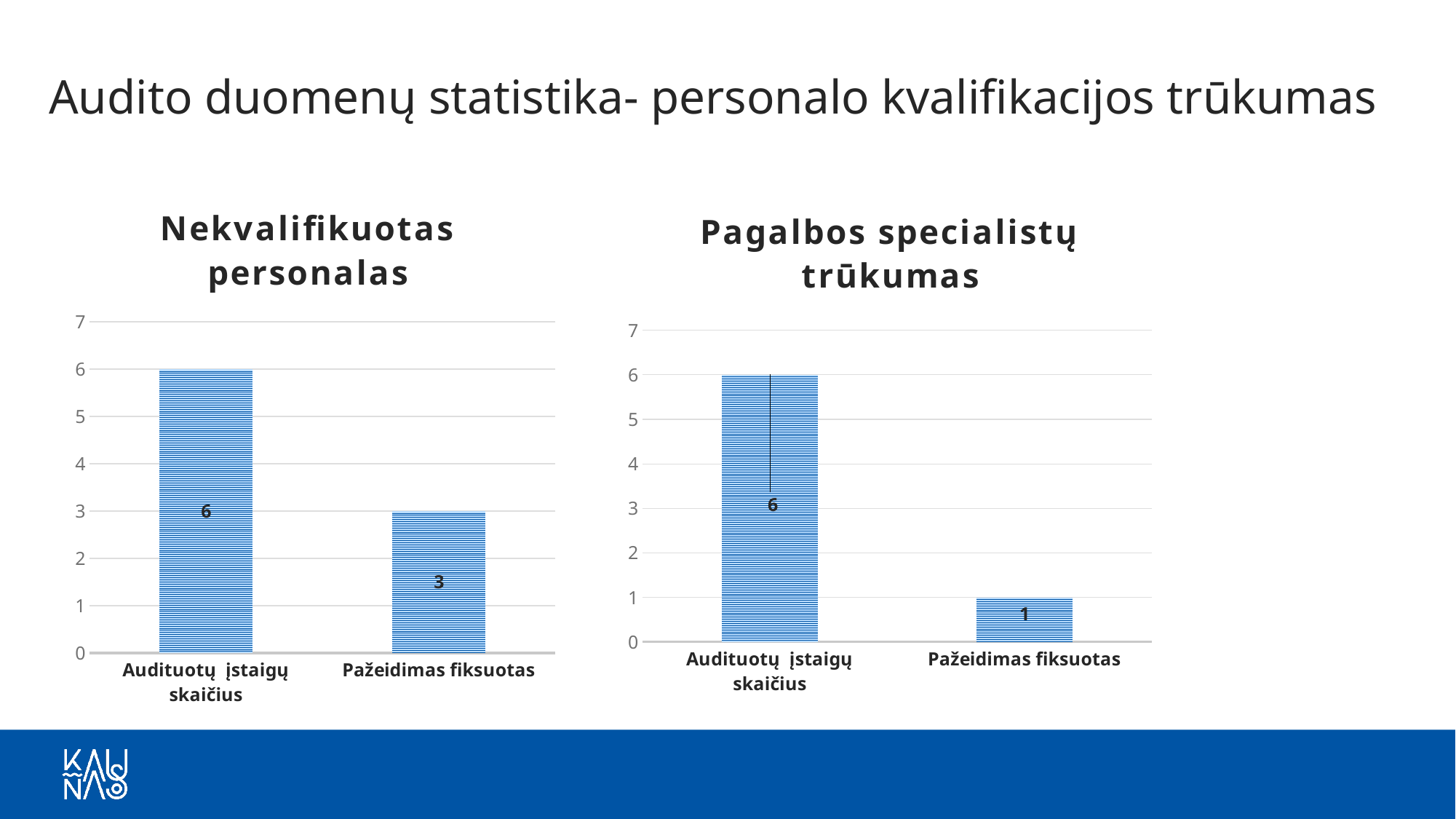
In the 'Nekvalifikuotas personalas' chart, what is the difference between 'Audituotų įstaigų skaičius' and 'Pažeidimas fiksuotas'? 3 In the 'Pagalbos specialistų trūkumas' chart, what is the value for 'Pažeidimas fiksuotas'? 1 In the 'Pagalbos specialistų trūkumas' chart, what is the value for 'Audituotų įstaigų skaičius'? 6 In the 'Nekvalifikuotas personalas' chart, what is the value for 'Audituotų įstaigų skaičius'? 6 In the 'Nekvalifikuotas personalas' chart, what is the value for 'Pažeidimas fiksuotas'? 3 In the 'Pagalbos specialistų trūkumas' chart, which category has the lowest value? Pažeidimas fiksuotas In the 'Nekvalifikuotas personalas' chart, which category has the highest value? Audituotų įstaigų skaičius Which is larger: 'Pažeidimas fiksuotas' in the 'Nekvalifikuotas personalas' chart or 'Pažeidimas fiksuotas' in the 'Pagalbos specialistų trūkumas' chart? Nekvalifikuotas personalas What is the title of the chart on the right side of the slide? Pagalbos specialistų trūkumas In the 'Pagalbos specialistų trūkumas' chart, what is the difference between 'Audituotų įstaigų skaičius' and 'Pažeidimas fiksuotas'? 5 How many categories are shown in the 'Pagalbos specialistų trūkumas' chart? 2 What kind of chart is the 'Nekvalifikuotas personalas' chart? Bar chart